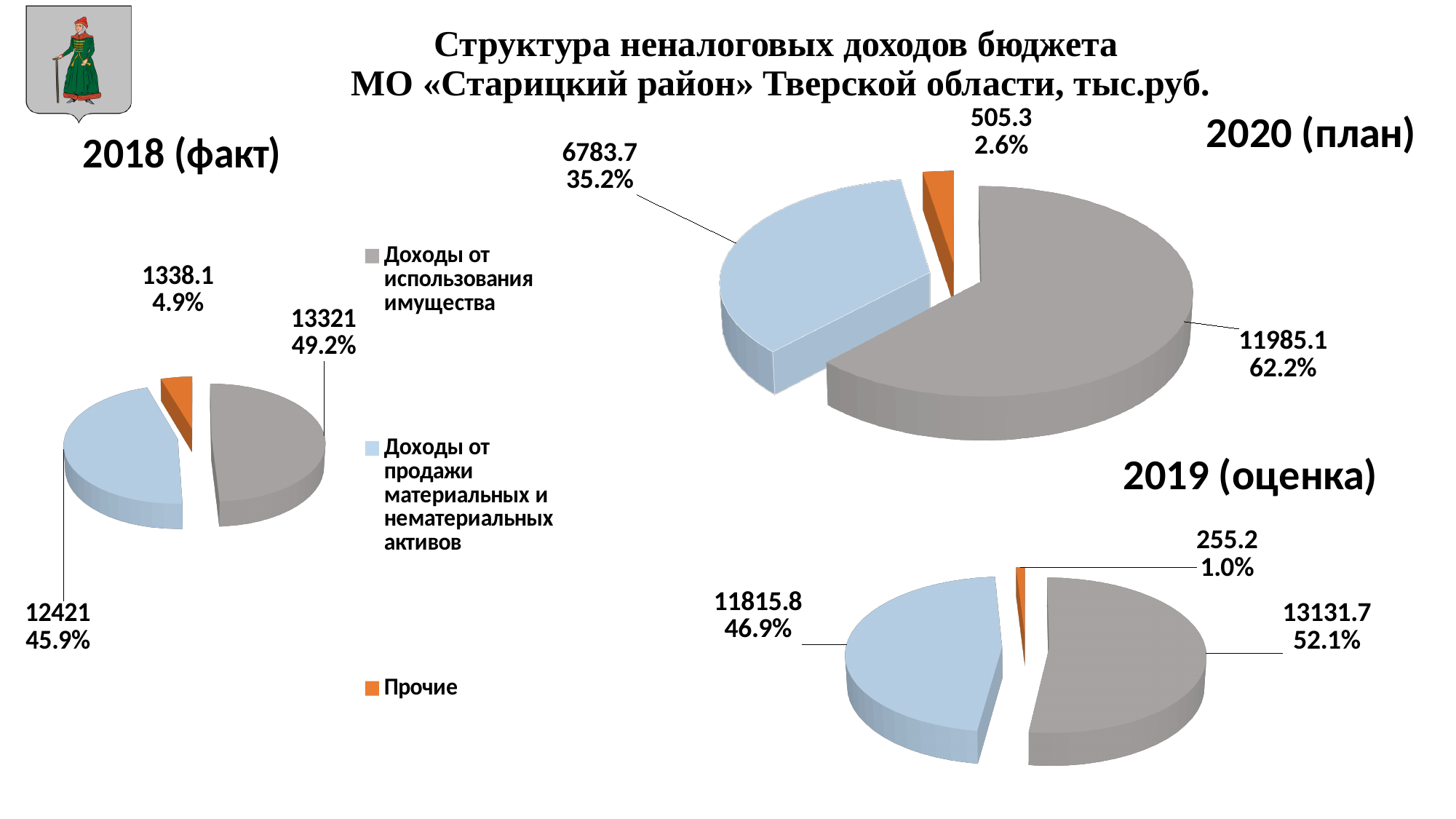
How many pie charts are shown on the slide? 3 In the 2018 (факт) chart, what value is shown for Доходы от использования имущества? 13321 In the 2020 (план) chart, what is the difference between the values for Доходы от использования имущества and Доходы от продажи материальных и нематериальных активов? 5201.4 In the 2019 (оценка) chart, what share of the pie is Доходы от использования имущества? 52.1% In the 2018 (факт) chart, what share of the pie is Прочие? 4.9% How many categories does the legend list? 3 In the 2020 (план) chart, what value is shown for Прочие? 505.3 In the 2020 (план) chart, what share of the pie is Доходы от продажи материальных и нематериальных активов? 35.2% In the 2019 (оценка) chart, which category has the smallest slice? Прочие In the 2018 (факт) chart, which is larger: Доходы от использования имущества or Доходы от продажи материальных и нематериальных активов? Доходы от использования имущества In the 2020 (план) chart, which category has the largest slice? Доходы от использования имущества In the 2019 (оценка) chart, what value is shown for Доходы от продажи материальных и нематериальных активов? 11815.8